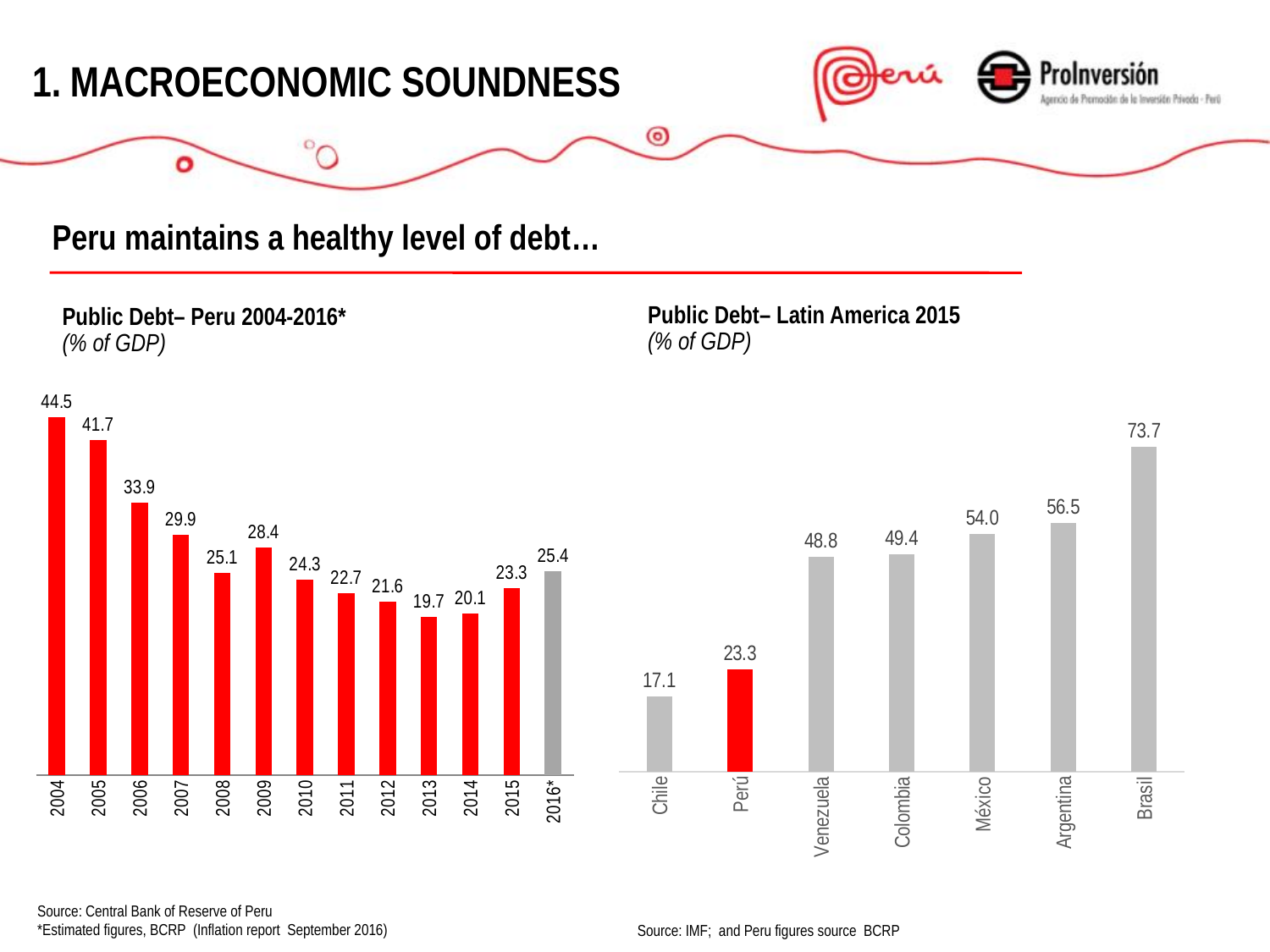
In the 'Public Debt– Peru 2004-2016*' chart, what is the value for 2004? 44.5 In the 'Public Debt– Peru 2004-2016*' chart, do the values generally rise or fall from 2004 to 2013? fall In the 'Public Debt– Latin America 2015' chart, which country has the highest value? Brasil In the 'Public Debt– Latin America 2015' chart, what is the difference between the values for Brasil and Perú? 50.4 In the 'Public Debt– Peru 2004-2016*' chart, which year has the lowest value? 2013 In the 'Public Debt– Latin America 2015' chart, which is larger, the value for Venezuela or Colombia? Colombia What type of chart is the 'Public Debt– Latin America 2015' chart? bar chart In the 'Public Debt– Peru 2004-2016*' chart, what is the difference between the values for 2004 and 2015? 21.2 In the 'Public Debt– Peru 2004-2016*' chart, how many years are shown? 13 In the 'Public Debt– Latin America 2015' chart, what is the value for México? 54.0 In the 'Public Debt– Peru 2004-2016*' chart, what is the value for 2016*? 25.4 In the 'Public Debt– Latin America 2015' chart, which country has the lowest value? Chile